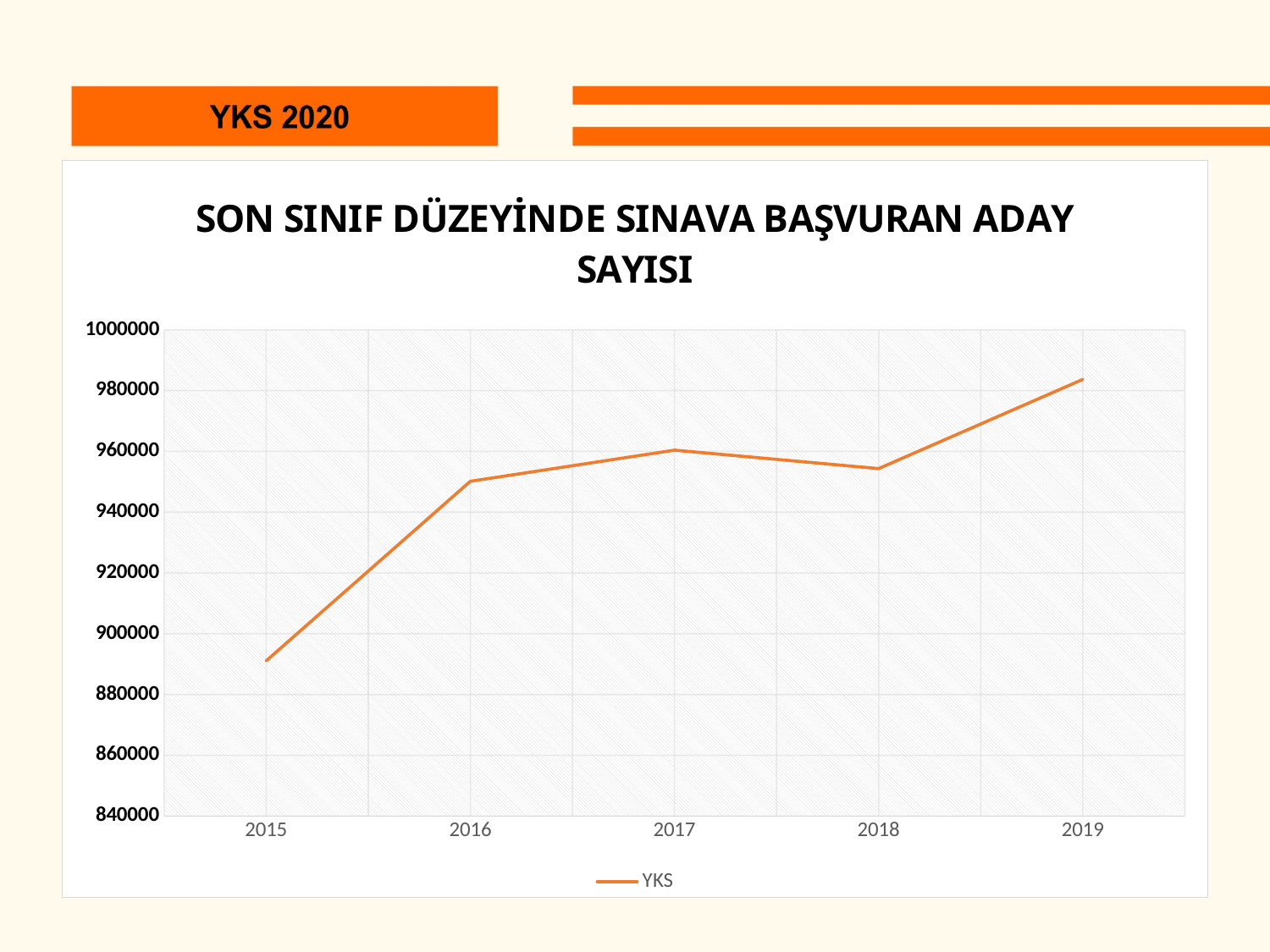
How many series does the legend list? 1 Overall, do the values rise or fall from 2015 to 2019? rise How many years are plotted on the x axis? 5 Is the value for 2016 greater or less than 940000? greater Which is larger, the value for 2015 or the value for 2016? 2016 Is the value for 2015 greater or less than 900000? less Which year has the highest value? 2019 What is the title of the chart? SON SINIF DÜZEYİNDE SINAVA BAŞVURAN ADAY SAYISI Is the value for 2019 greater or less than 960000? greater Which year has the lowest value? 2015 What kind of chart is shown on the slide? line chart What is the name of the series shown in the legend? YKS